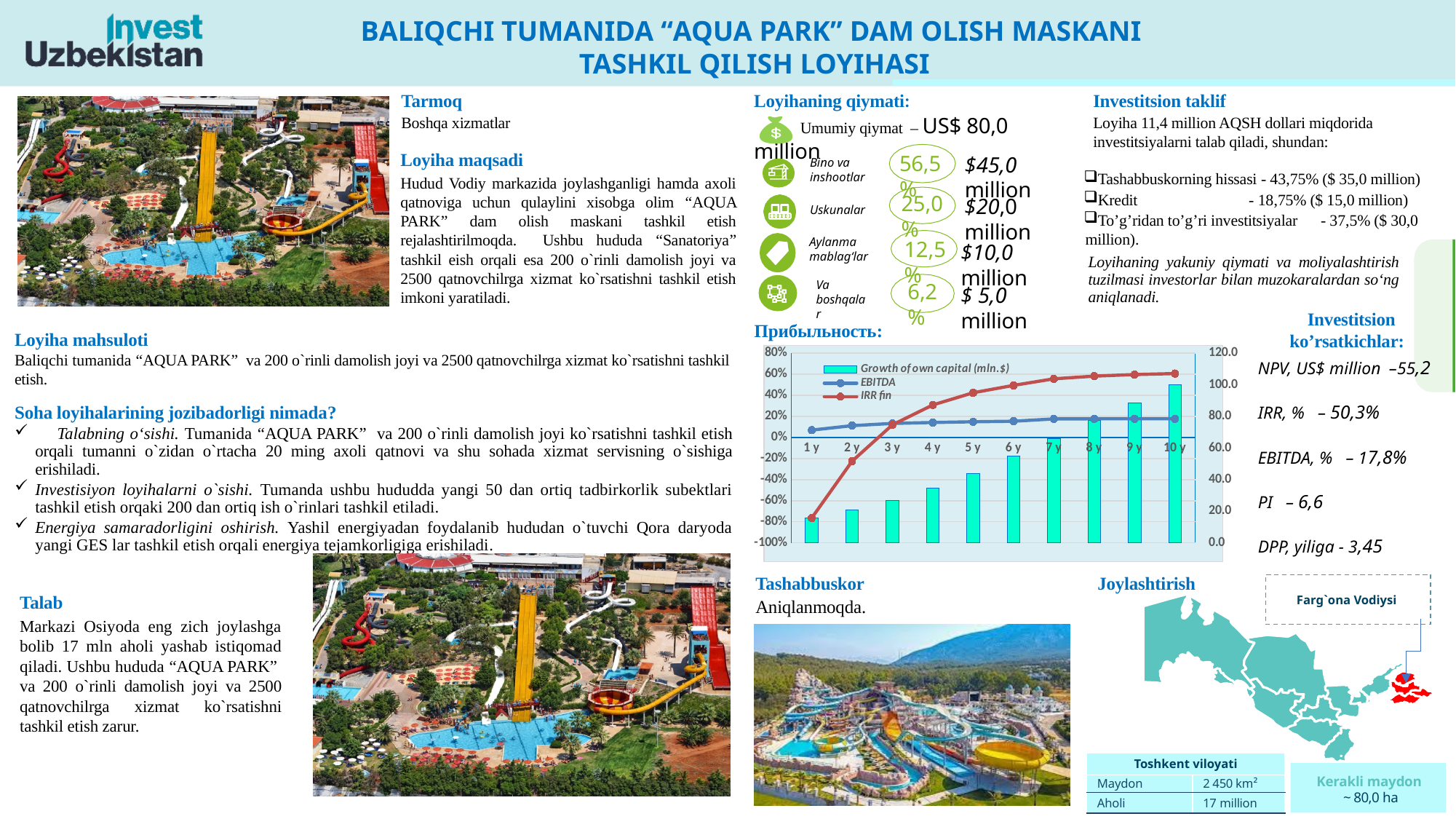
Do the Growth of own capital bars rise or fall from 1 y to 10 y? Rise In which year is the IRR fin value lowest? 1 y Is the IRR fin value at 10 y greater or less than 40%? greater How many series does the chart legend list? 3 Does the IRR fin line rise or fall from 1 y to 10 y? Rises At 10 y, which is higher: IRR fin or EBITDA? IRR fin What is the title of the chart on the slide? Прибыльность: Which series in the chart is drawn as bars? Growth of own capital (mln.$) Is the IRR fin value at 2 y greater or less than 0%? less Is the IRR fin value at 1 y greater or less than -60%? less What kind of chart is shown under Прибыльность? Combined bar and line chart How many year categories are shown on the x axis of the chart? 10